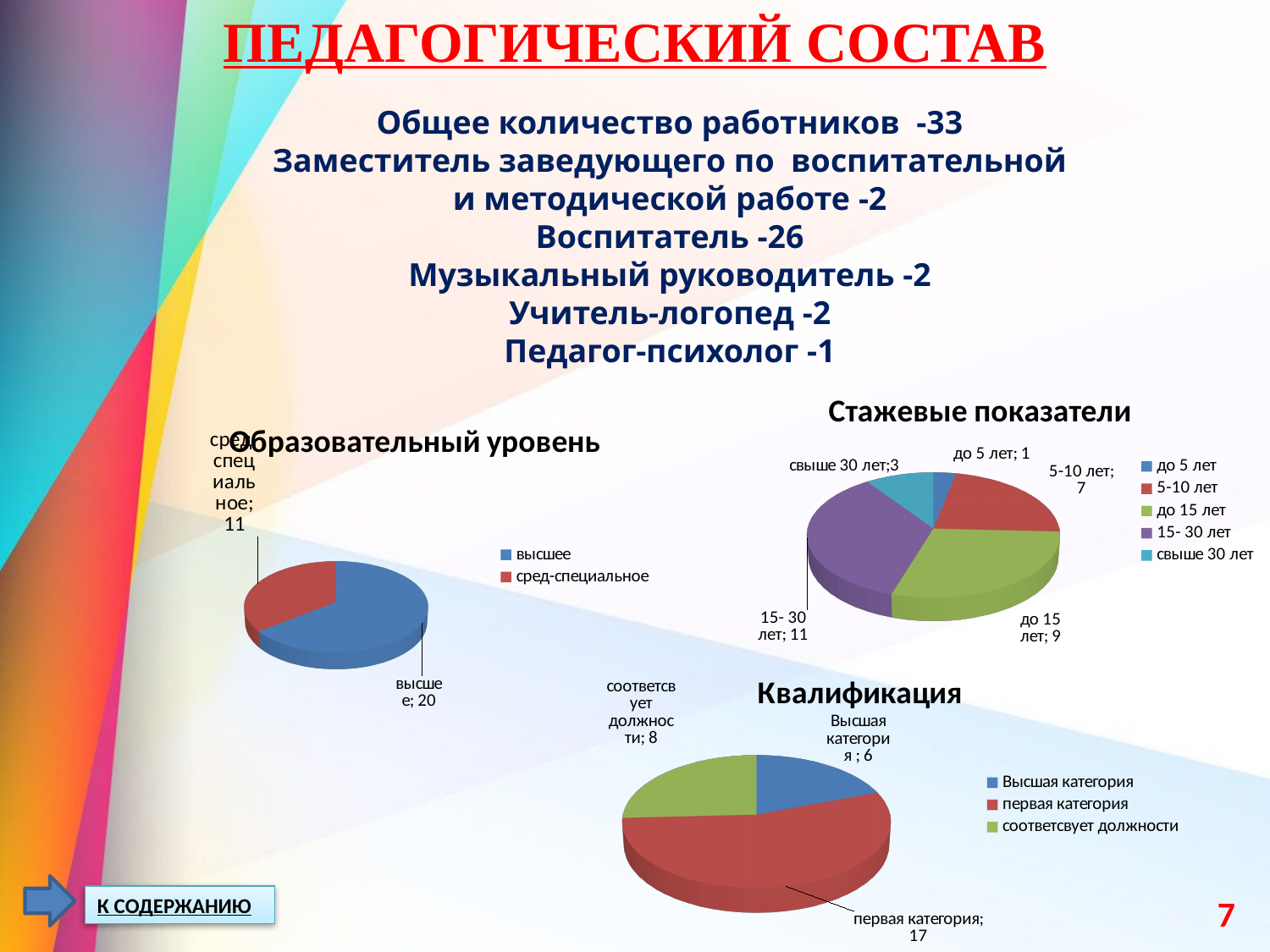
In the 'Образовательный уровень' chart, what is the difference between 'высшее' and 'сред-специальное'? 9 How many slices does the 'Квалификация' chart have? 3 In the 'Образовательный уровень' chart, what is the value for 'сред-специальное'? 11 In the 'Квалификация' chart, what is the value for 'первая категория'? 17 In the 'Образовательный уровень' chart, what is the value for 'высшее'? 20 How many categories does the legend of the 'Стажевые показатели' chart list? 5 In the 'Квалификация' chart, what is the difference between 'первая категория' and 'Высшая категория'? 11 In the 'Стажевые показатели' chart, which category has the highest value? 15- 30 лет In the 'Стажевые показатели' chart, which is larger: '5-10 лет' or 'до 15 лет'? до 15 лет What kind of chart is 'Стажевые показатели'? pie chart In the 'Стажевые показатели' chart, which category has the lowest value? до 5 лет In the 'Стажевые показатели' chart, what is the value for '15- 30 лет'? 11